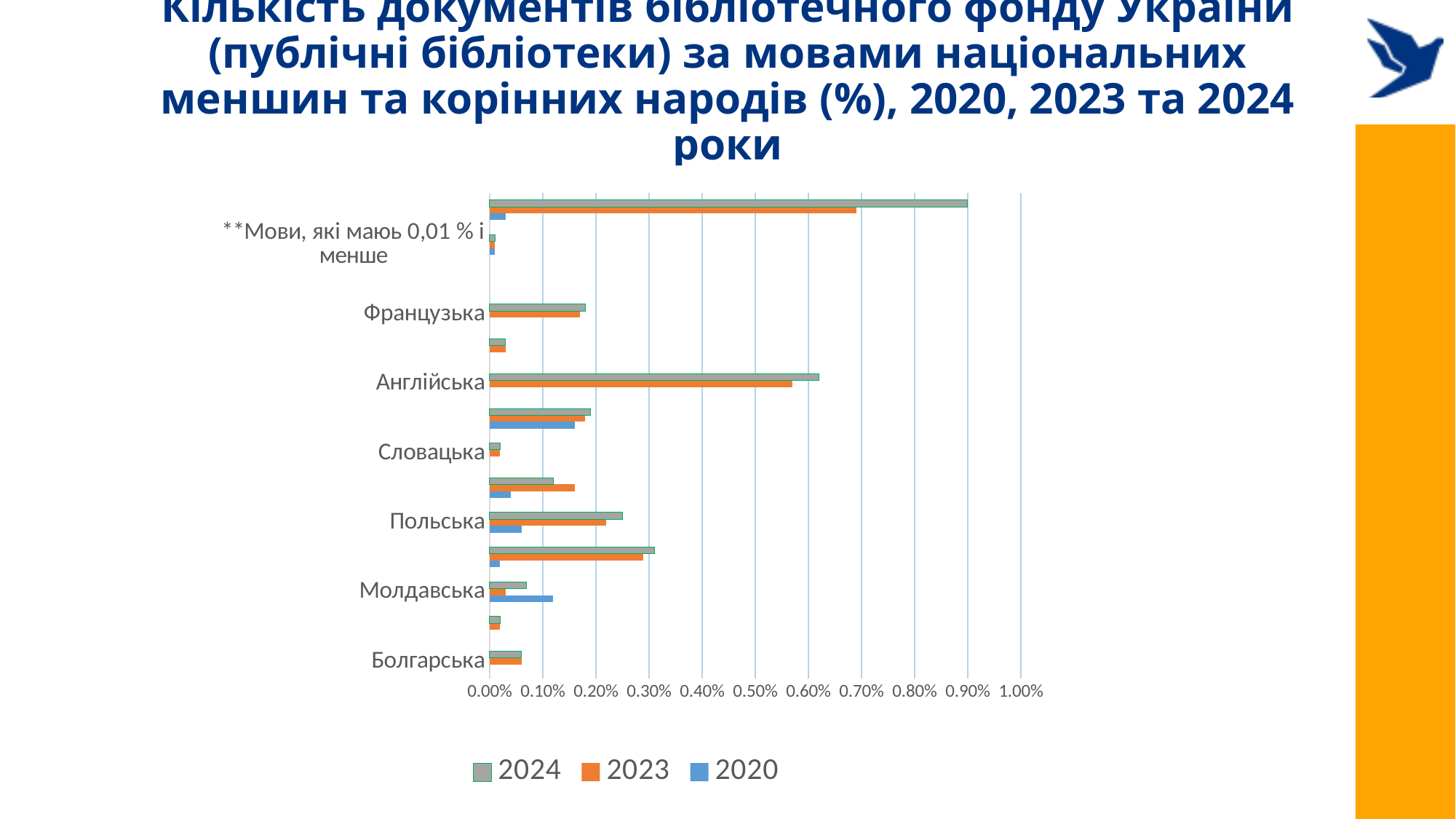
Is the 2023 value for Англійська greater or less than 0.50%? greater Which has the larger 2024 value, Англійська or Польська? Англійська Is the 2024 value for Болгарська greater or less than 0.10%? less For Польська, which year has the larger value, 2024 or 2020? 2024 What are the legend entries of the chart? 2024, 2023, 2020 Is the 2024 value for Польська greater or less than 0.20%? greater For Молдавська, which year has the larger value, 2020 or 2024? 2020 Among Англійська, Польська and Французька, which has the highest 2024 value? Англійська What kind of chart is shown on the slide? bar chart How many series does the legend list? 3